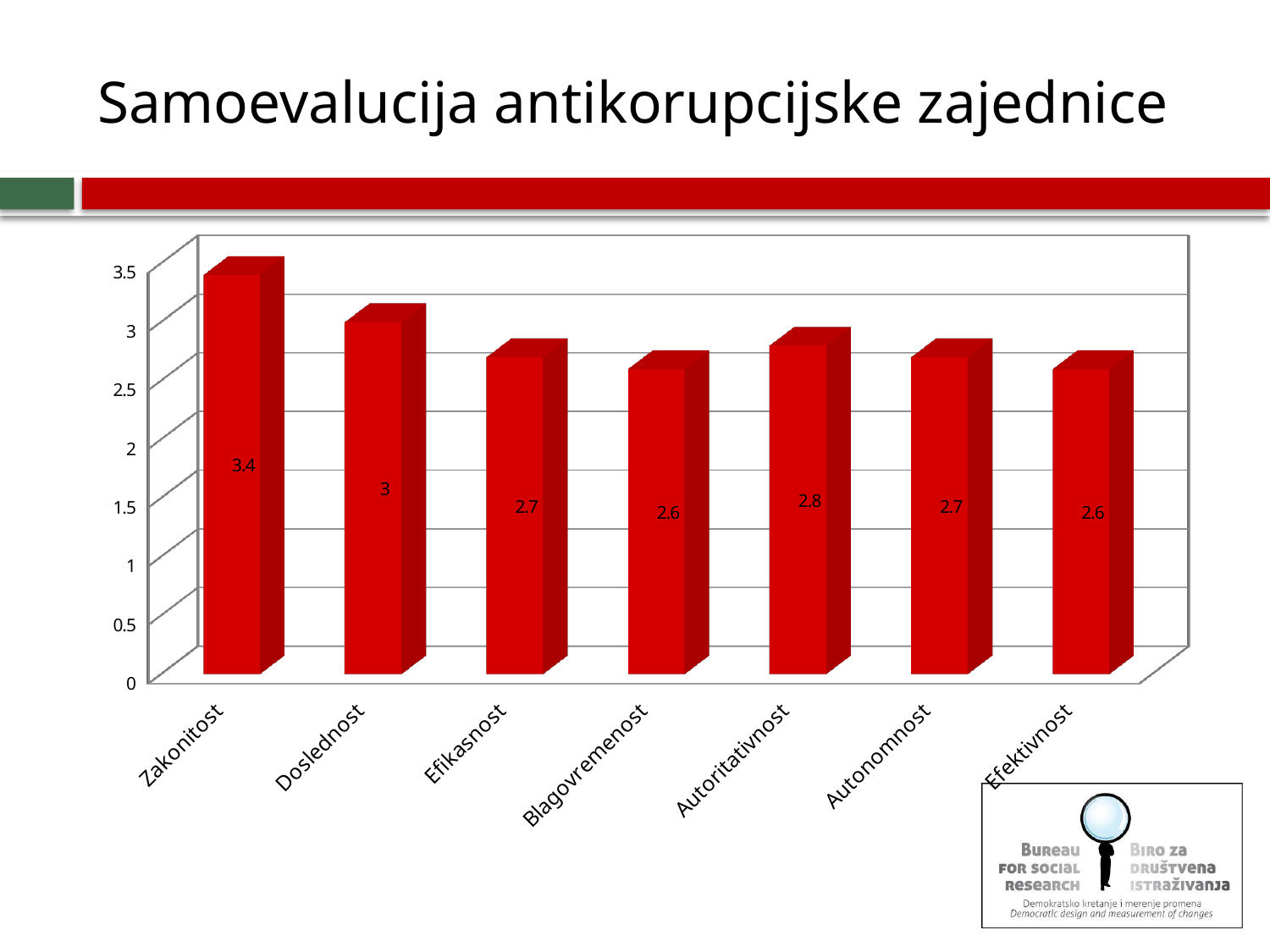
What is the title of the slide containing the chart? Samoevalucija antikorupcijske zajednice Which is larger, the value for Doslednost or the value for Efikasnost? Doslednost How many categories are shown on the x axis? 7 What is the value for Autoritativnost? 2.8 What is the difference between the values for Autoritativnost and Efektivnost? 0.2 What is the value for Doslednost? 3 What kind of chart is shown on the slide? bar chart What is the value for Blagovremenost? 2.6 Is the value for Autonomnost greater or less than 3? less Which category has the highest value? Zakonitost What is the value for Zakonitost? 3.4 What is the difference between the values for Zakonitost and Doslednost? 0.4